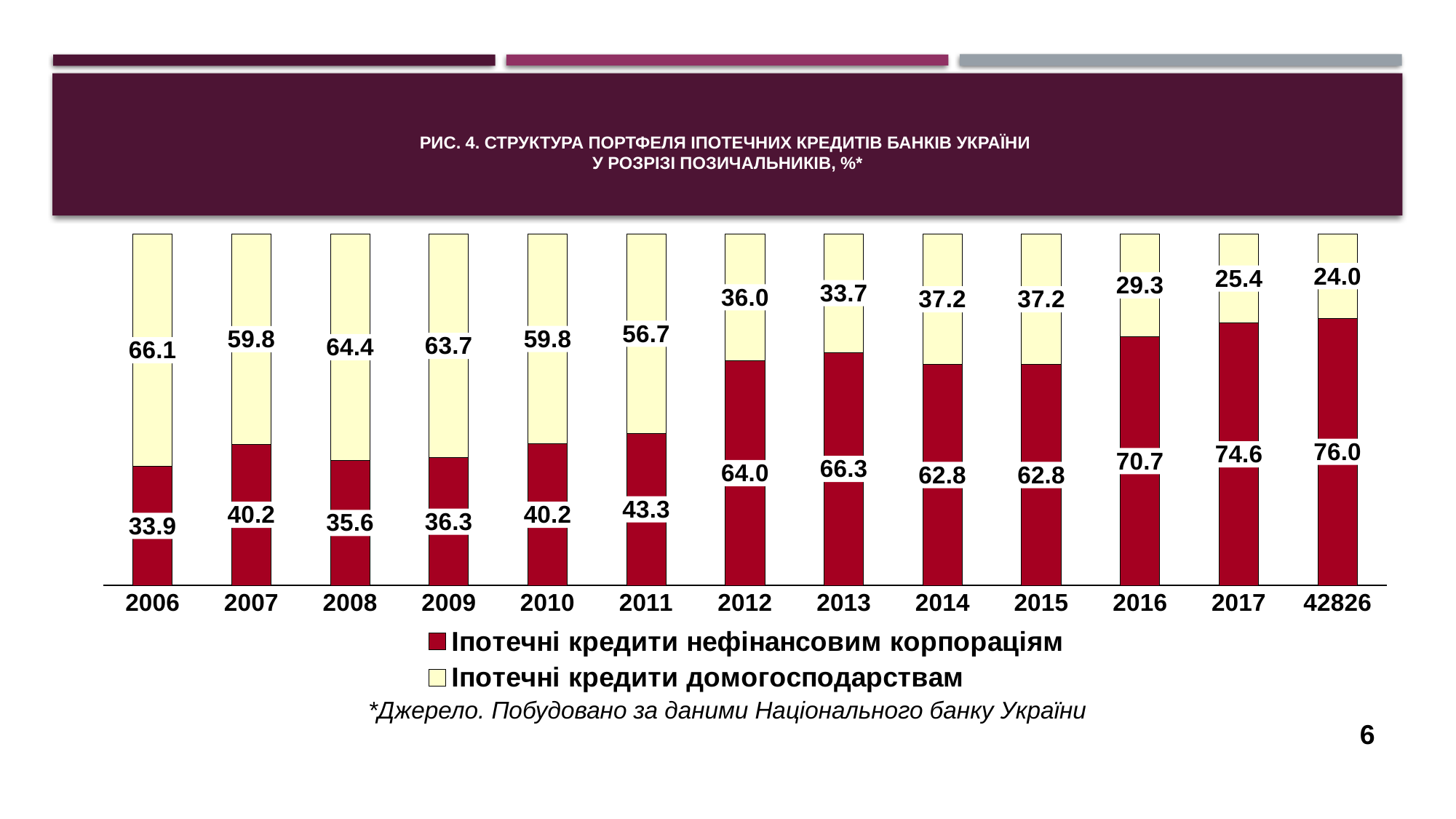
In which year is the value for 'Іпотечні кредити домогосподарствам' the highest? 2006 How many series does the legend list? 2 How many bars (categories) are shown on the x axis? 13 What is the value for 'Іпотечні кредити домогосподарствам' in 2011? 56.7 Does the value for 'Іпотечні кредити домогосподарствам' rise or fall from 2014 to the last bar? Fall What is the difference between the 'Іпотечні кредити нефінансовим корпораціям' values for 2013 and 2012? 2.3 What kind of chart is shown on the slide? Stacked bar chart In which year is the value for 'Іпотечні кредити нефінансовим корпораціям' the lowest? 2006 Which is larger in 2010: the value for 'Іпотечні кредити нефінансовим корпораціям' or for 'Іпотечні кредити домогосподарствам'? Іпотечні кредити домогосподарствам What is the value for 'Іпотечні кредити нефінансовим корпораціям' in 2017? 74.6 What is the total of the stacked bar for 2016? 100.0 What is the value for 'Іпотечні кредити нефінансовим корпораціям' in 2006? 33.9